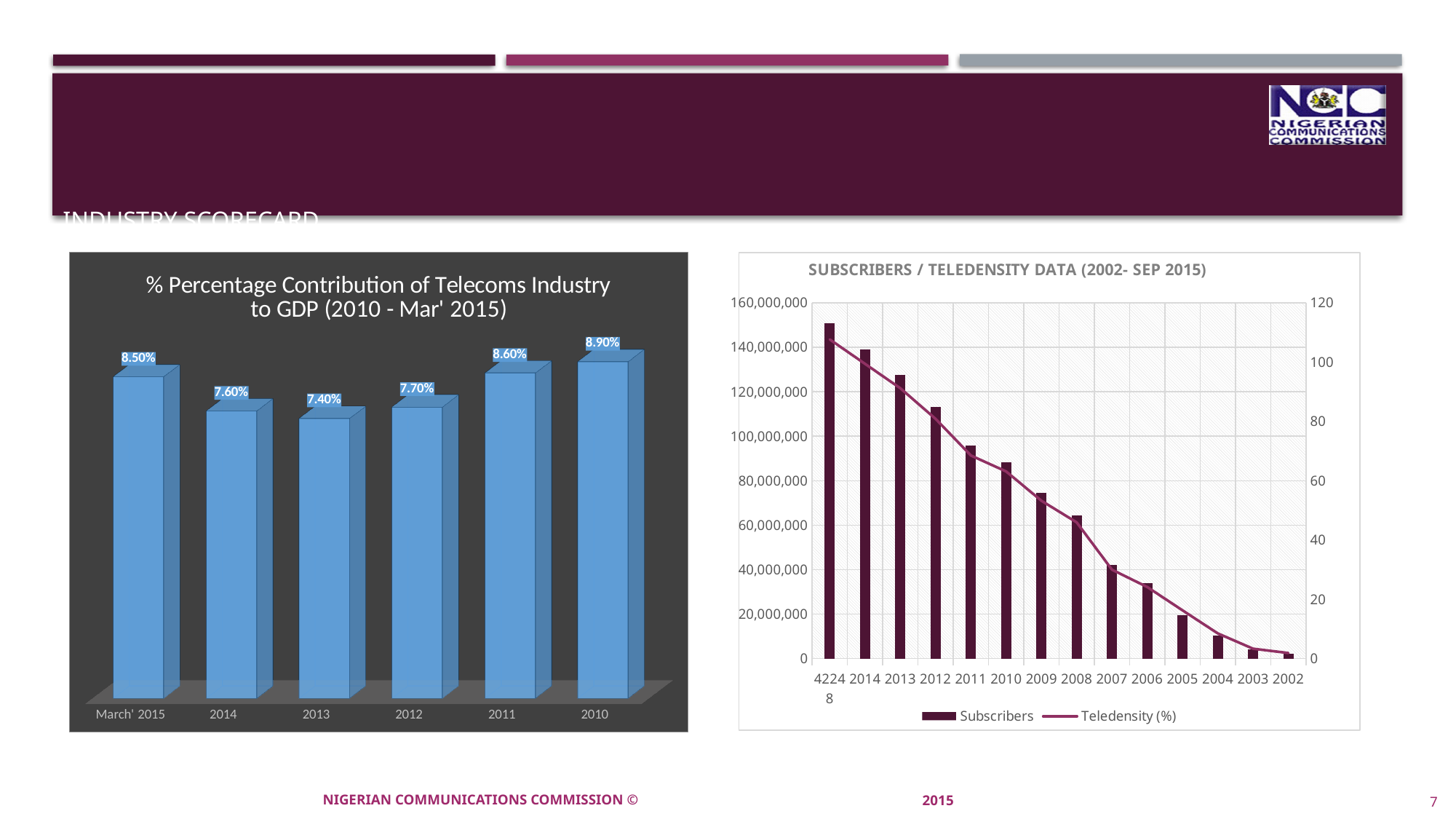
On the left chart (% Percentage Contribution of Telecoms Industry to GDP), which category has the highest value? 2010 How many series does the legend of the right chart (SUBSCRIBERS / TELEDENSITY DATA) list? 2 On the left chart (% Percentage Contribution of Telecoms Industry to GDP), which category has the lowest value? 2013 On the left chart (% Percentage Contribution of Telecoms Industry to GDP), which is larger, the value for 2011 or the value for 2012? 2011 On the right chart (SUBSCRIBERS / TELEDENSITY DATA), do the Subscribers values rise or fall moving from left to right along the x axis? fall What kind of chart is the left chart (% Percentage Contribution of Telecoms Industry to GDP)? Bar chart On the right chart (SUBSCRIBERS / TELEDENSITY DATA), is the Subscribers value for 2002 greater or less than 20,000,000? less On the left chart (% Percentage Contribution of Telecoms Industry to GDP), what is the value for 2013? 7.40% On the right chart (SUBSCRIBERS / TELEDENSITY DATA), is the Subscribers value for 2014 greater or less than 120,000,000? greater On the left chart (% Percentage Contribution of Telecoms Industry to GDP), what is the value for March' 2015? 8.50% How many bars are shown on the left chart (% Percentage Contribution of Telecoms Industry to GDP)? 6 On the left chart (% Percentage Contribution of Telecoms Industry to GDP), what is the difference between the values for 2010 and 2014? 1.30%